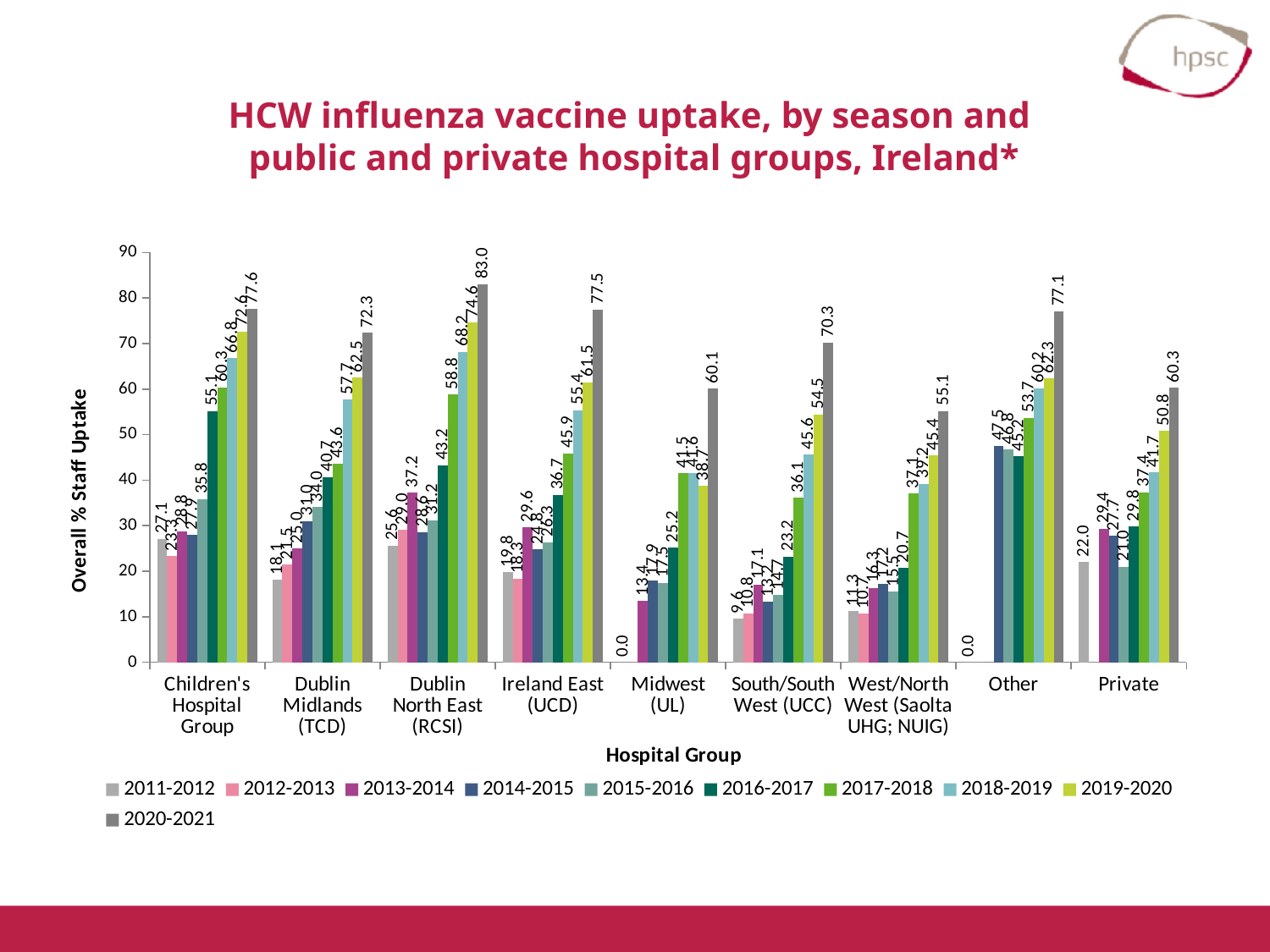
Which hospital group has the highest 2020-2021 uptake? Dublin North East (RCSI) Is the 2019-2020 value for Private greater or less than 60? less What is the label of the y axis? Overall % Staff Uptake How many seasons (series) does the legend list? 10 How many hospital groups are shown on the x axis? 9 What is the difference between the 2020-2021 values for Dublin North East (RCSI) and West/North West (Saolta UHG; NUIG)? 27.9 Which hospital group has the lowest 2020-2021 uptake? West/North West (Saolta UHG; NUIG) What is the 2020-2021 uptake value for Dublin North East (RCSI)? 83.0 Which is larger, the 2020-2021 value for Dublin Midlands (TCD) or for South/South West (UCC)? Dublin Midlands (TCD) What type of chart is shown on the slide? Bar chart What is the 2020-2021 uptake value for Private? 60.3 What is the 2011-2012 uptake value for Midwest (UL)? 0.0